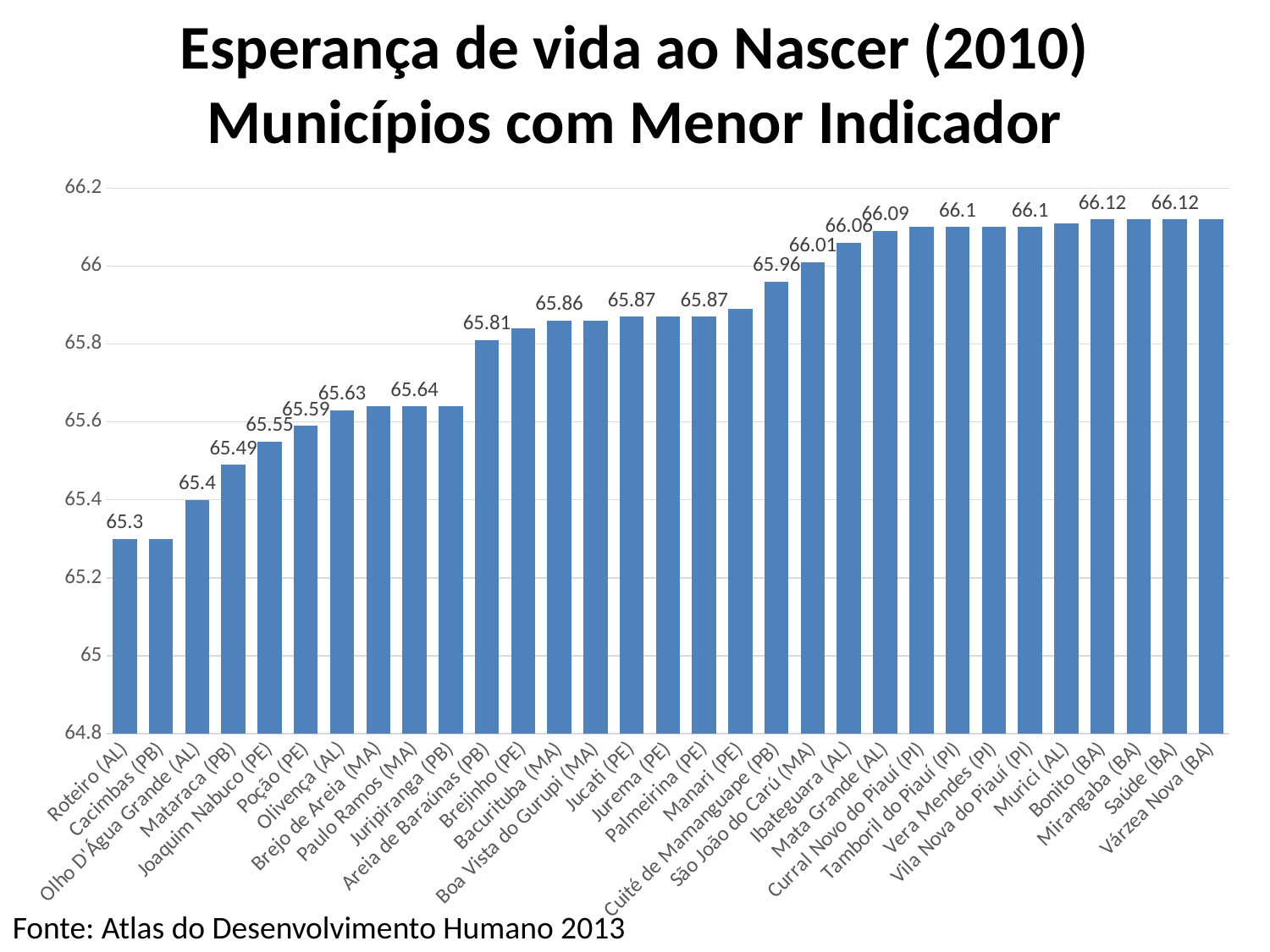
What source is cited below the chart? Atlas do Desenvolvimento Humano 2013 How many municipalities are shown on the x axis? 31 Do the values generally rise or fall from left to right along the x axis? Rise What type of chart is shown on the slide? Bar chart What is the life expectancy value shown for Roteiro (AL)? 65.3 Is the value for Jucati (PE) greater or less than 66? less What is the difference between the values for Mata Grande (AL) and Roteiro (AL)? 0.79 What value is labelled for Cuité de Mamanguape (PB)? 65.96 What value is labelled for Areia de Baraúnas (PB)? 65.81 Which has the larger value, Mata Grande (AL) or Roteiro (AL)? Mata Grande (AL) Is the value for Várzea Nova (BA) greater or less than 66? greater What value is labelled for Mata Grande (AL)? 66.09